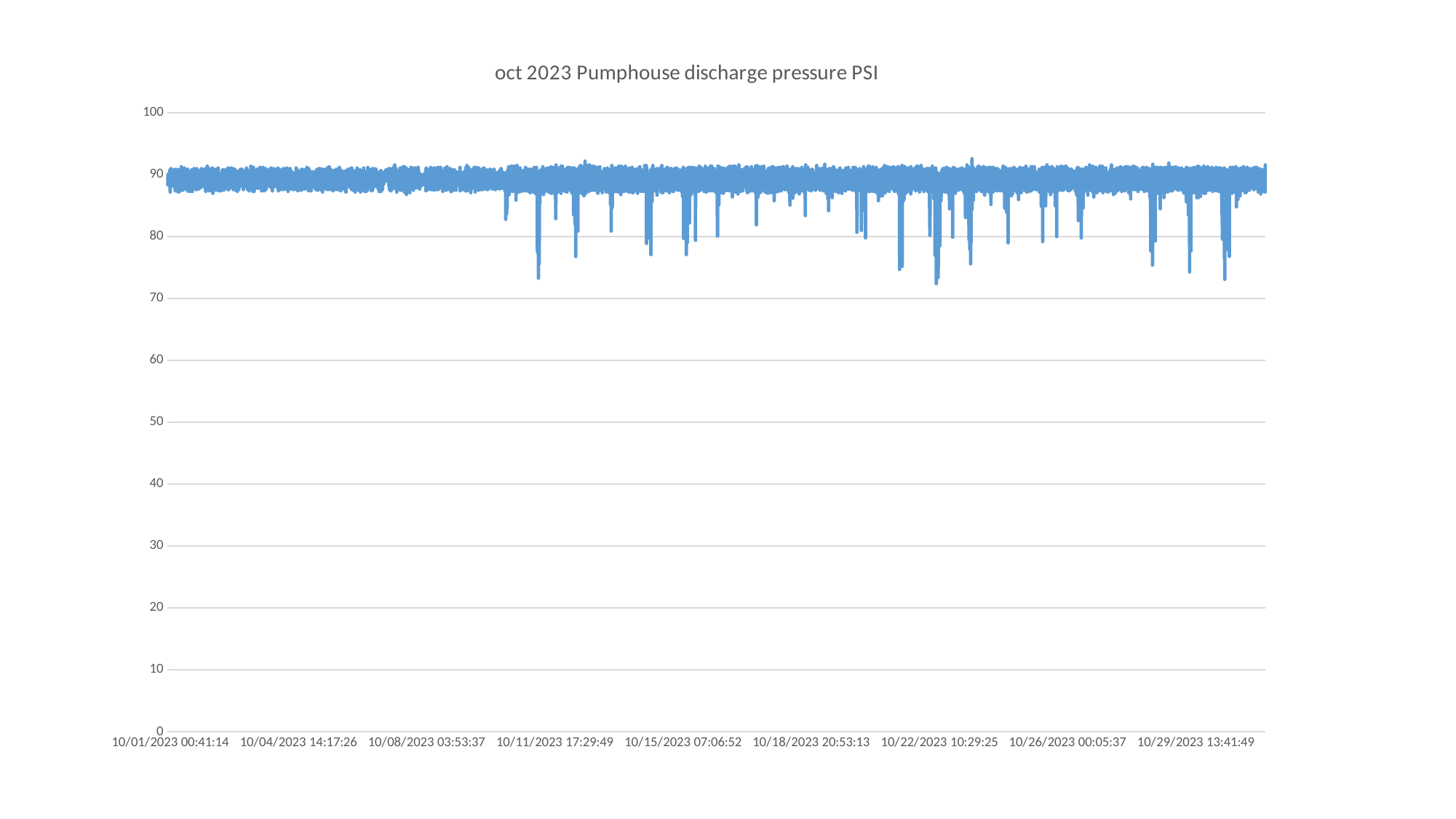
Do the values generally rise, fall, or stay roughly level across the x axis? stay roughly level Is the lowest value plotted on the chart greater or less than 70? greater Is the highest value plotted on the chart greater or less than 100? less How many date labels are shown along the x axis? 9 What is the title of the chart? oct 2023 Pumphouse discharge pressure PSI What kind of chart is shown on the slide? line chart Is the value at 10/29/2023 13:41:49 greater or less than 50? greater What is the first date label on the x axis? 10/01/2023 00:41:14 What is the last date label on the x axis? 10/29/2023 13:41:49 What is the highest value shown on the y axis? 100